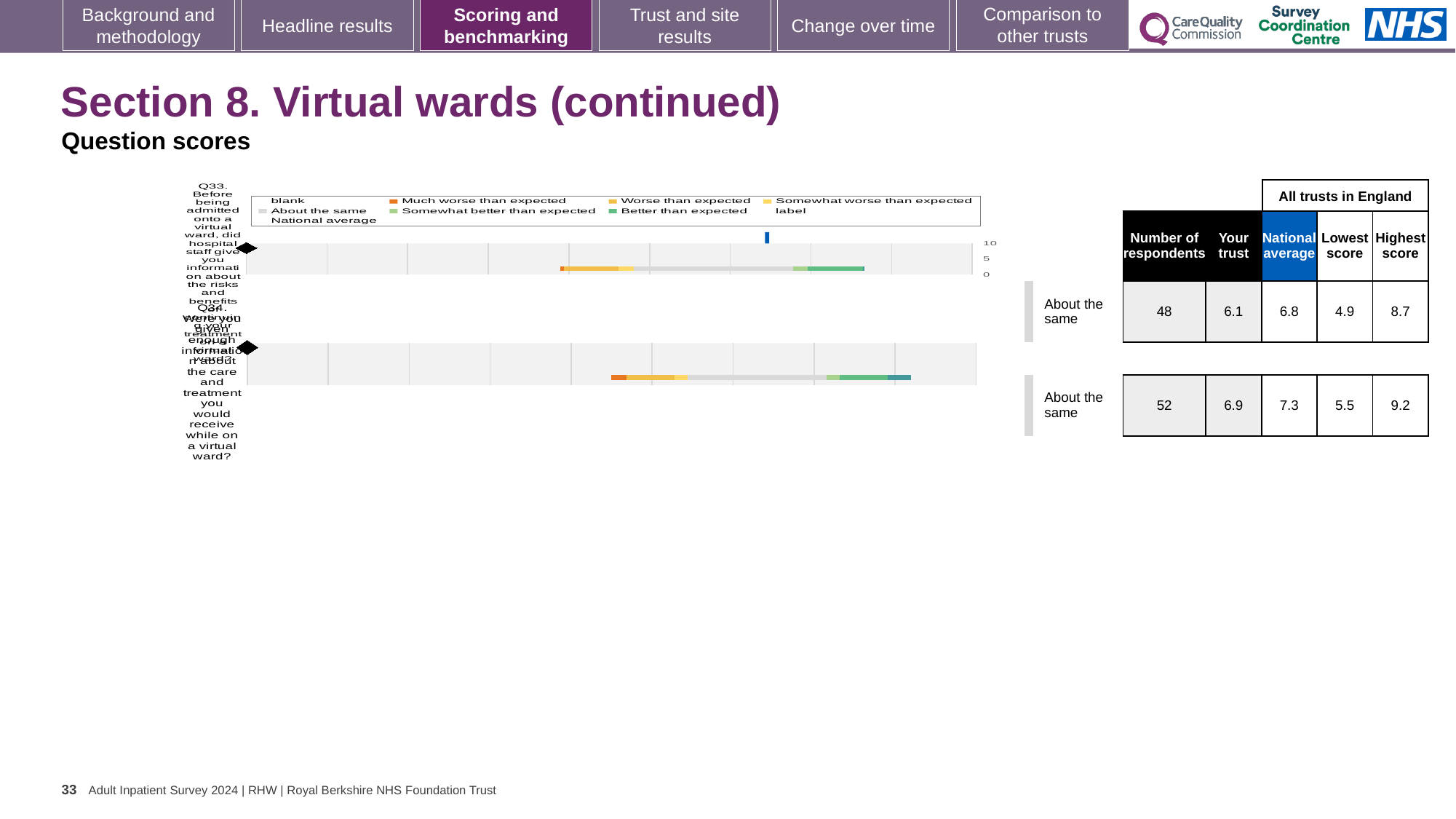
How many entries does the chart legend list? 9 In the table beside the chart, what is the 'Your trust' score for Q34? 6.9 In the table beside the chart, what is the 'Your trust' score for Q33? 6.1 In the table beside the chart, what is the number of respondents for Q34? 52 In the table beside the chart, what is the national average for Q33? 6.8 What kind of chart is shown on the slide? bar chart What is the highest tick value shown on the chart's axis? 10 Which question has the higher 'Your trust' score in the table, Q33 or Q34? Q34 Which legend entry is shown in light grey? About the same Which legend entry is shown in orange? Much worse than expected What is the difference between the highest score and lowest score for Q34 in the table? 3.7 How many questions (categories) are plotted in the chart? 2